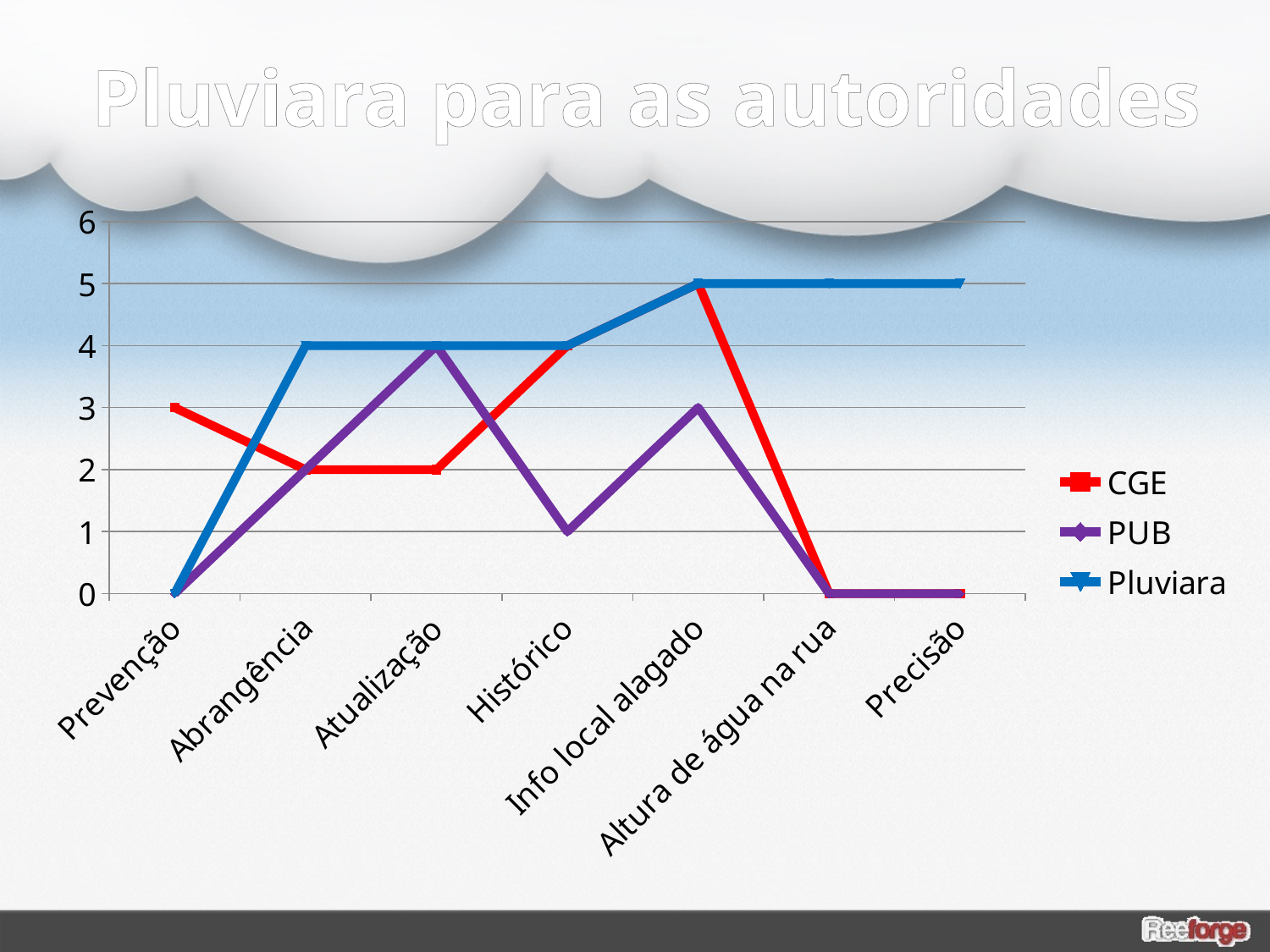
What is the difference between Pluviara and PUB at Info local alagado? 2 What is the value for CGE at Altura de água na rua? 0 Which is larger at Prevenção, CGE or PUB? CGE How many categories are shown on the x axis? 7 At which category does PUB reach its highest value? Atualização What kind of chart is shown on the slide? line chart Which series has the highest value at Precisão? Pluviara Which series is drawn in red? CGE What is the value for Pluviara at Abrangência? 4 What is the value for PUB at Histórico? 1 What is the value for CGE at Prevenção? 3 How many series does the legend list? 3